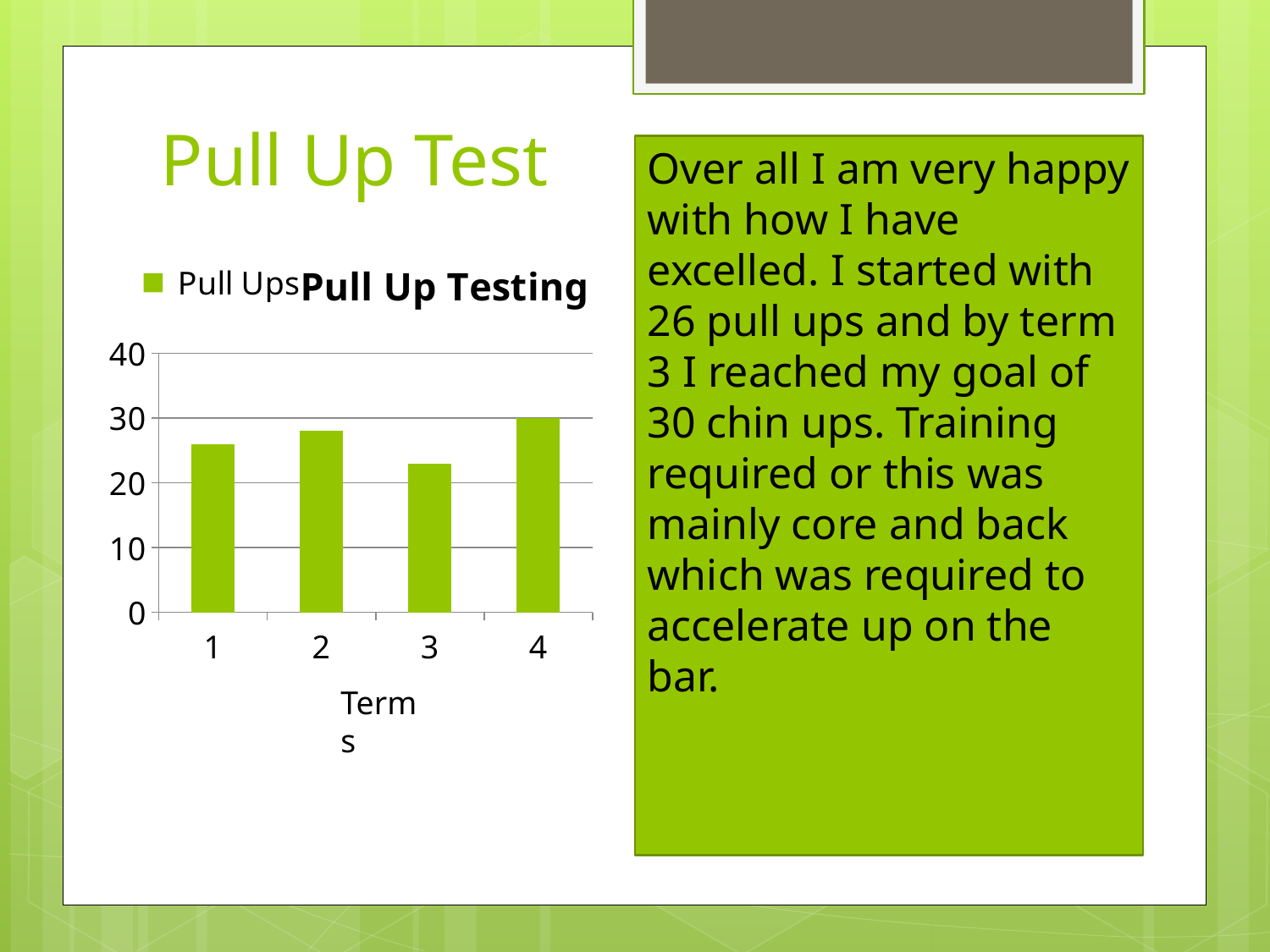
Does the value rise or fall from term 3 to term 4? rise How many series does the legend list? 1 What is the title of the chart? Pull Up Testing Is the value for term 1 greater or less than 20? greater Is the value for term 2 greater or less than 30? less Which term has the highest number of pull ups? 4 How many terms are plotted on the chart? 4 What kind of chart is shown on the slide? bar chart Which is larger, the value for term 2 or the value for term 3? term 2 What is the value for term 4? 30 What series does the chart legend list? Pull Ups Which term has the lowest number of pull ups? 3